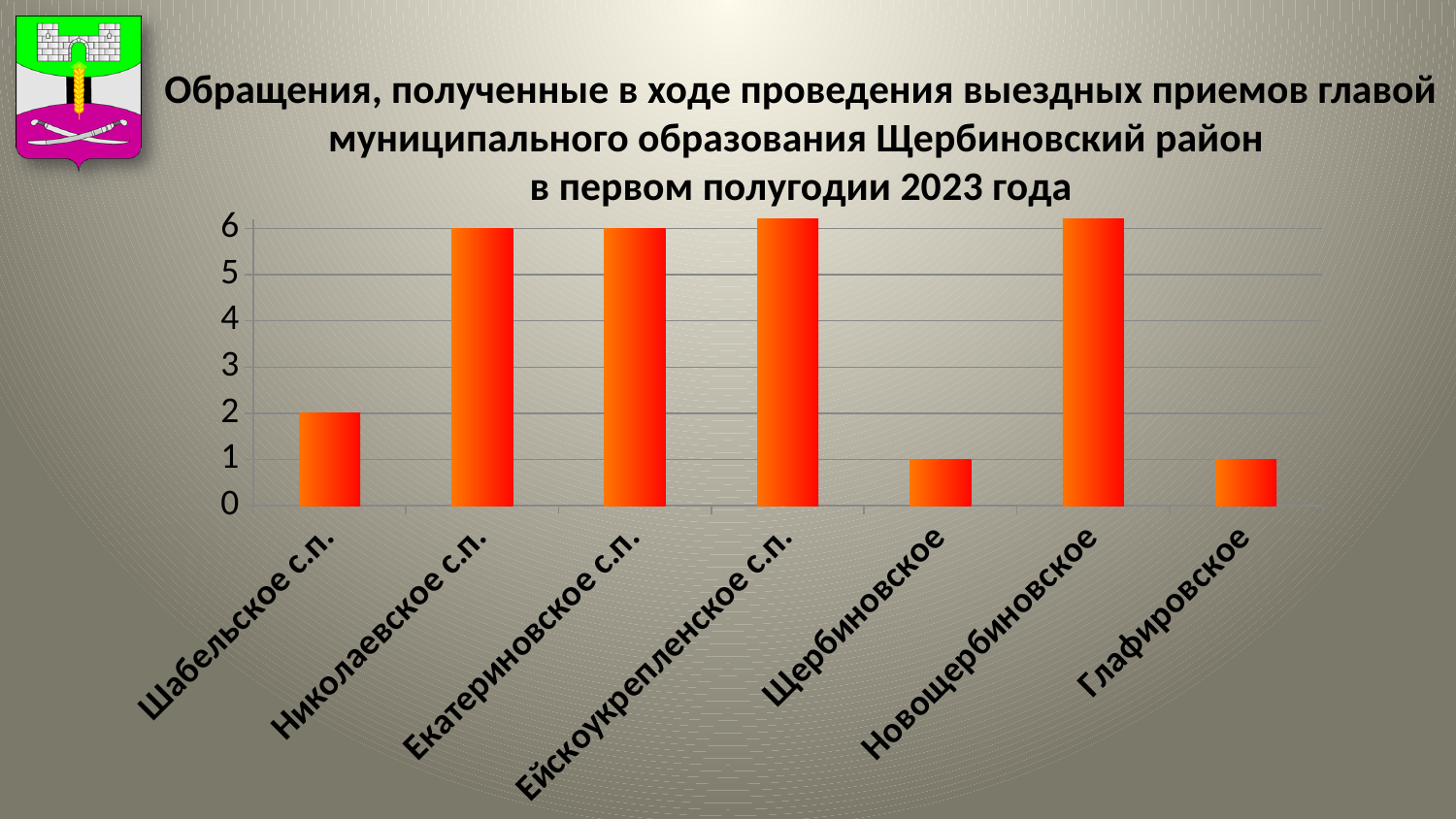
What is the value for Николаевское с.п.? 6 Which has a larger value, Николаевское с.п. or Шабельское с.п.? Николаевское с.п. What is the difference between the values for Екатериновское с.п. and Щербиновское? 5 Which period does the chart title say the data covers? в первом полугодии 2023 года How many categories (settlements) are shown on the x axis of the chart? 7 What is the value for Екатериновское с.п.? 6 What is the value for Щербиновское? 1 What type of chart is shown on the slide? bar chart What is the value for Шабельское с.п.? 2 Is the value for Ейскоукрепленское с.п. greater or less than 5? greater What is the value for Глафировское? 1 Is the value for Новощербиновское greater or less than 4? greater